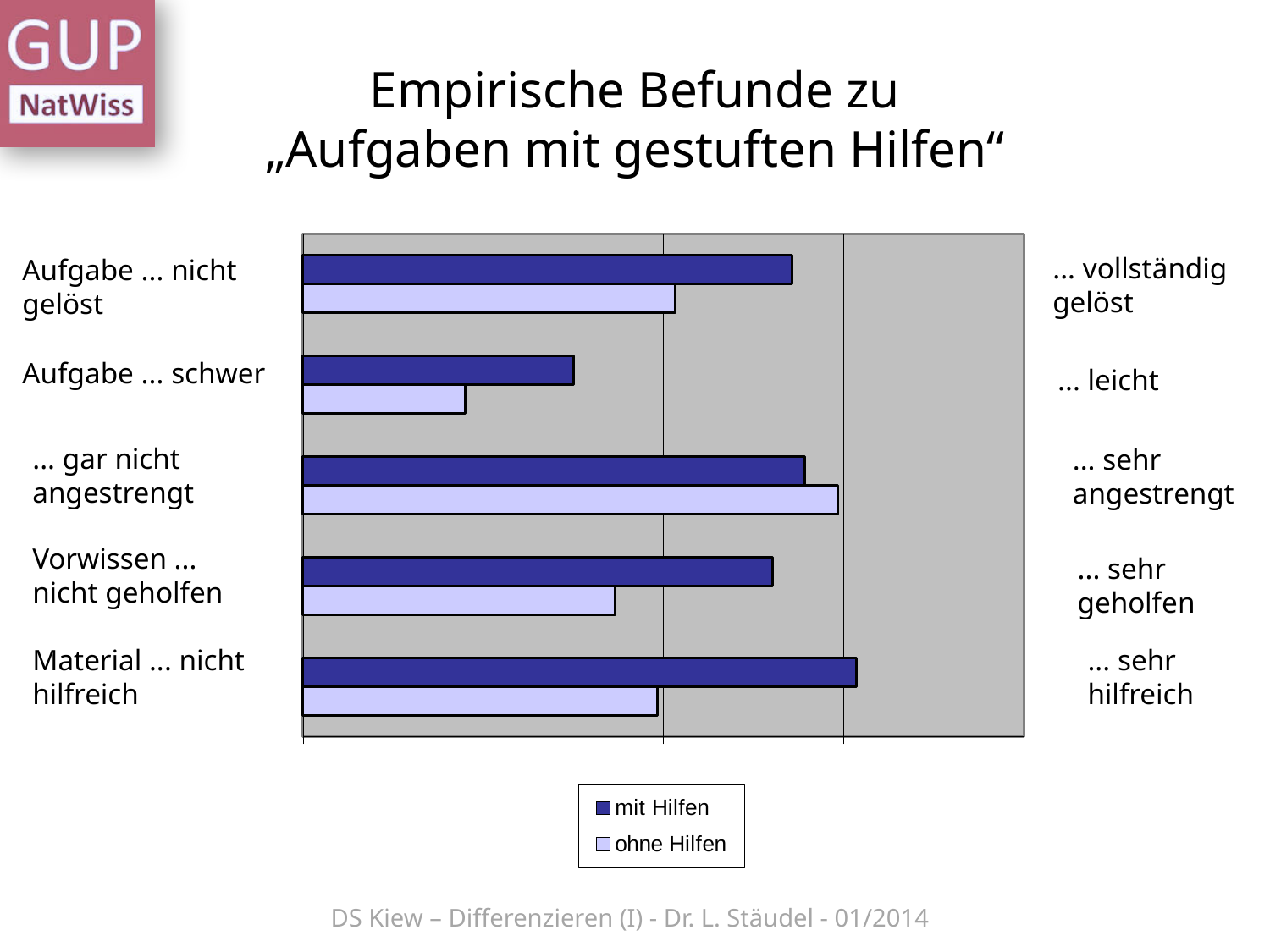
Which series has the longer bar for the item 'Vorwissen ... nicht geholfen / ... sehr geholfen'? mit Hilfen What are the two entries listed in the chart legend? mit Hilfen, ohne Hilfen For which item is the 'mit Hilfen' bar the shortest? Aufgabe ... schwer / ... leicht What kind of chart is shown on the slide? Bar chart Which series has the longer bar for the item 'Aufgabe ... schwer / ... leicht': mit Hilfen or ohne Hilfen? mit Hilfen How many series does the legend list? 2 How many categories (pairs of bars) are plotted in the chart? 5 What is the title of the slide containing the chart? Empirische Befunde zu „Aufgaben mit gestuften Hilfen“ For which item is the 'ohne Hilfen' bar the longest? ... gar nicht angestrengt / ... sehr angestrengt For which item is the 'mit Hilfen' bar the longest? Material ... nicht hilfreich / ... sehr hilfreich Which series has the longer bar for the item '... gar nicht angestrengt / ... sehr angestrengt': mit Hilfen or ohne Hilfen? ohne Hilfen